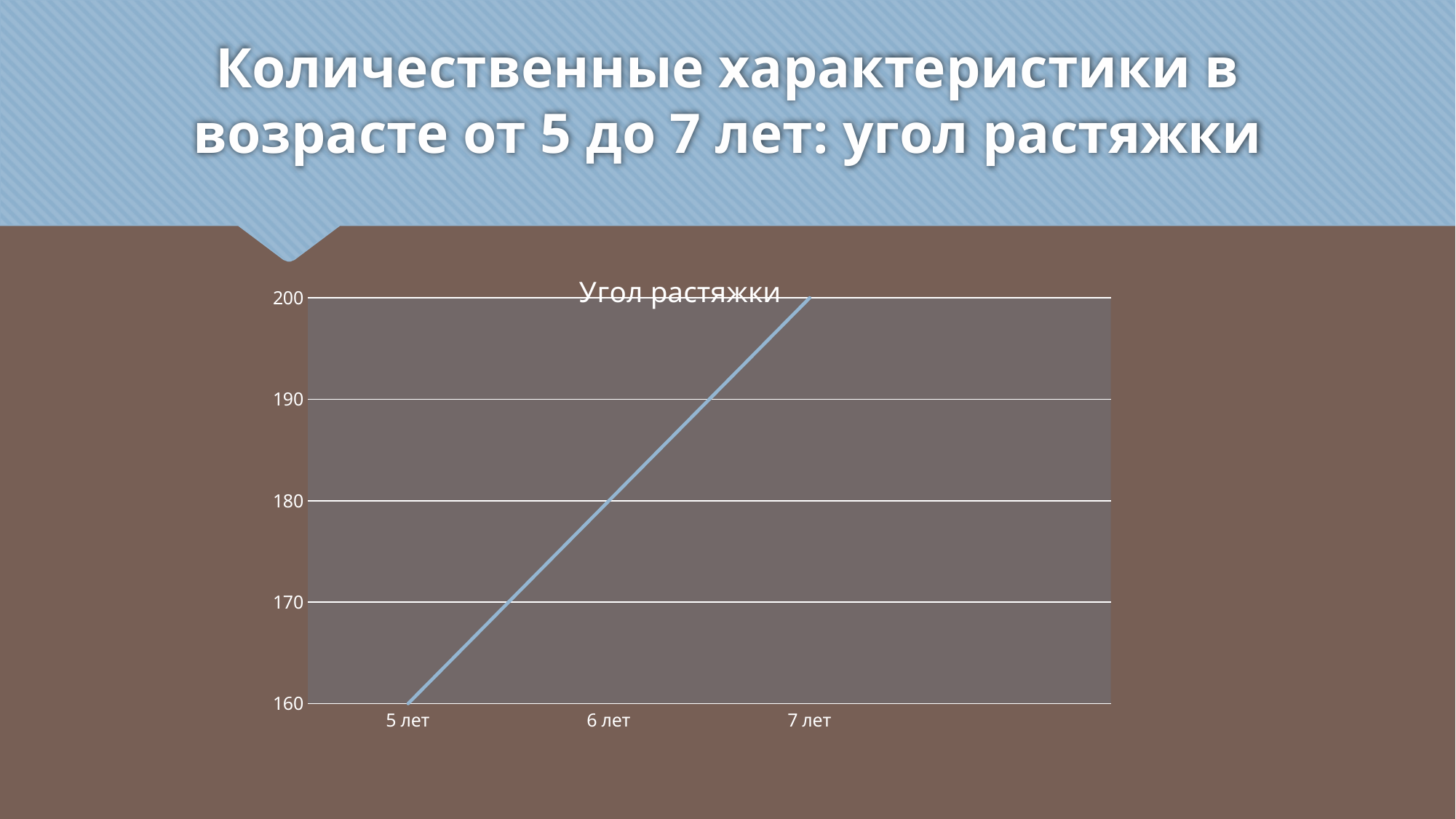
Which age has the highest value? 7 лет What is the value for 6 лет? 180 Which age has the lowest value? 5 лет What is the difference between the values for 7 лет and 5 лет? 40 What is the title of the chart? Угол растяжки Do the values rise or fall from 5 лет to 7 лет? rise Is the value for 6 лет greater or less than 170? greater What kind of chart is shown on the slide? line chart What is the value for 7 лет? 200 What is the value for 5 лет? 160 Which is larger, the value for 6 лет or the value for 5 лет? 6 лет How many age categories are shown on the x axis? 3